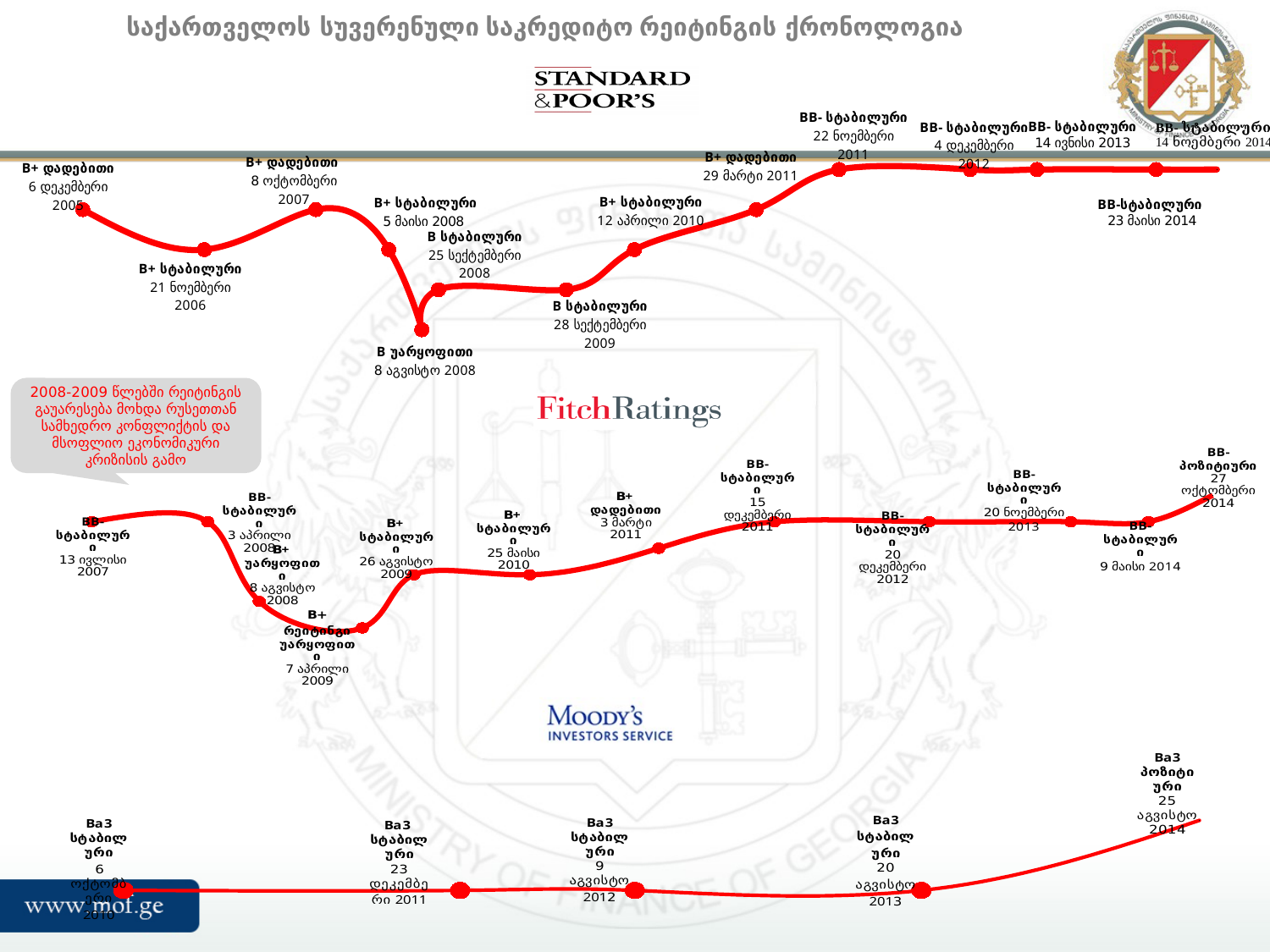
Which three rating agencies are shown on the slide? Standard & Poor's, Fitch Ratings, Moody's Investors Service In the Fitch Ratings chart, what rating is shown for 3 მარტი 2011? B+ დადებითი What kind of chart is used to show the Standard & Poor's rating chronology? line chart In the Moody's chart, does the line end higher or lower than it starts? higher How many rating agencies have their own chart on the slide? 3 In the Fitch Ratings chart, what rating is shown for 27 ოქტომბერი 2014? BB- პოზიტიური In the Moody's chart, how many data points are plotted? 5 In the Moody's chart, what rating is shown for 25 აგვისტო 2014? Ba3 პოზიტიური In the Standard & Poor's chart, what rating is shown for 22 ნოემბერი 2011? BB- სტაბილური In the Standard & Poor's chart, what rating is shown for 8 აგვისტო 2008? B უარყოფითი In the Moody's chart, what rating is shown for 6 ოქტომბერი 2010? Ba3 სტაბილური In the Standard & Poor's chart, what rating is shown for 6 დეკემბერი 2005? B+ დადებითი